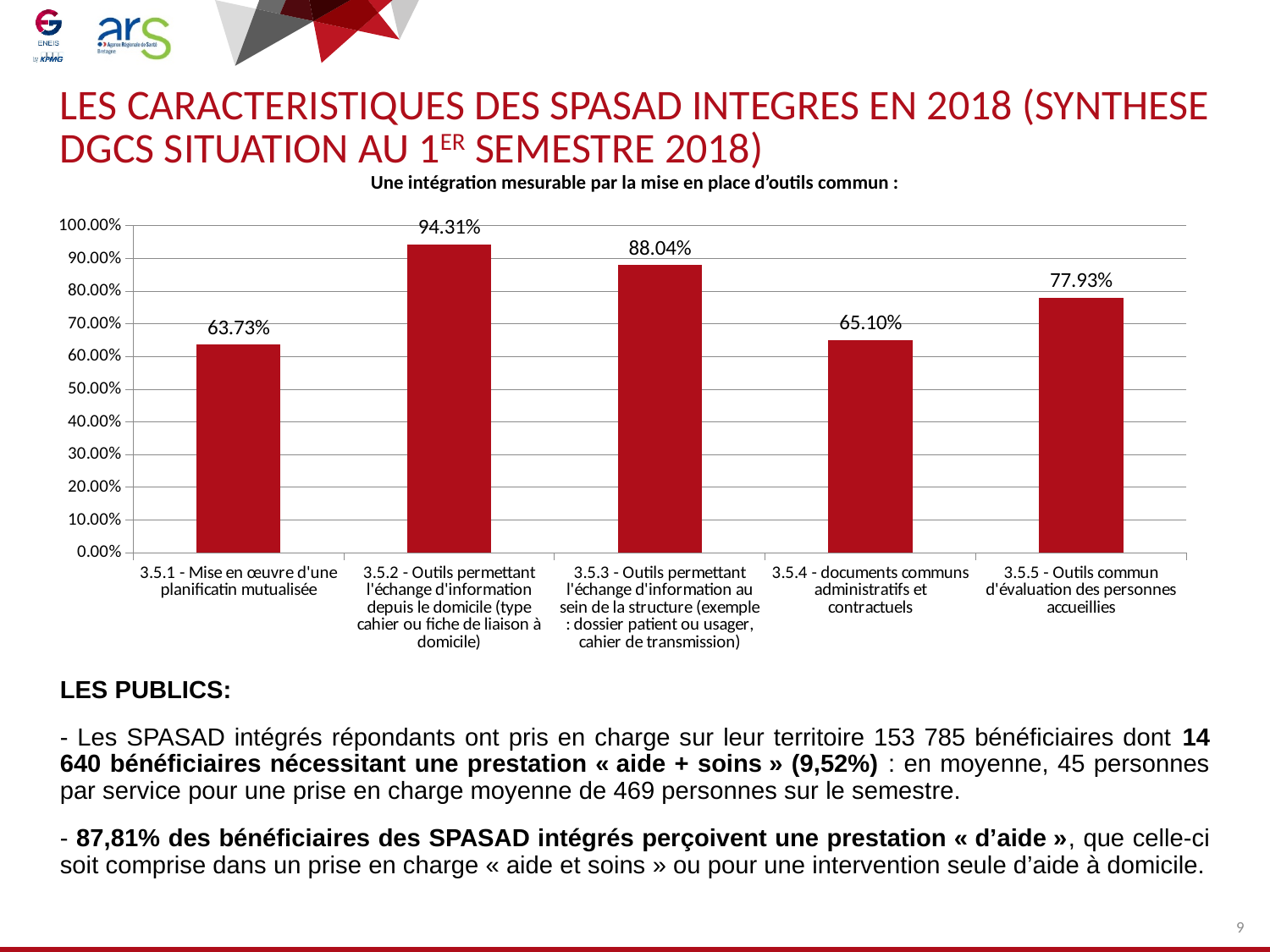
What is the title of the chart? Une intégration mesurable par la mise en place d'outils commun : What is the difference between the values for 3.5.4 and 3.5.1? 1.37% Which is larger, the value for 3.5.4 - documents communs administratifs et contractuels or the value for 3.5.5 - Outils commun d'évaluation des personnes accueillies? 3.5.5 - Outils commun d'évaluation des personnes accueillies What is the value for 3.5.2 - Outils permettant l'échange d'information depuis le domicile? 94.31% What is the difference between the values for 3.5.2 and 3.5.3? 6.27% What kind of chart is shown on the slide? Bar chart How many categories are shown in the chart? 5 Is the value for 3.5.3 - Outils permettant l'échange d'information au sein de la structure greater or less than 80.00%? greater What is the value for 3.5.1 - Mise en œuvre d'une planificatin mutualisée? 63.73% Which category has the lowest value? 3.5.1 - Mise en œuvre d'une planificatin mutualisée Which category has the highest value? 3.5.2 - Outils permettant l'échange d'information depuis le domicile What is the value for 3.5.5 - Outils commun d'évaluation des personnes accueillies? 77.93%